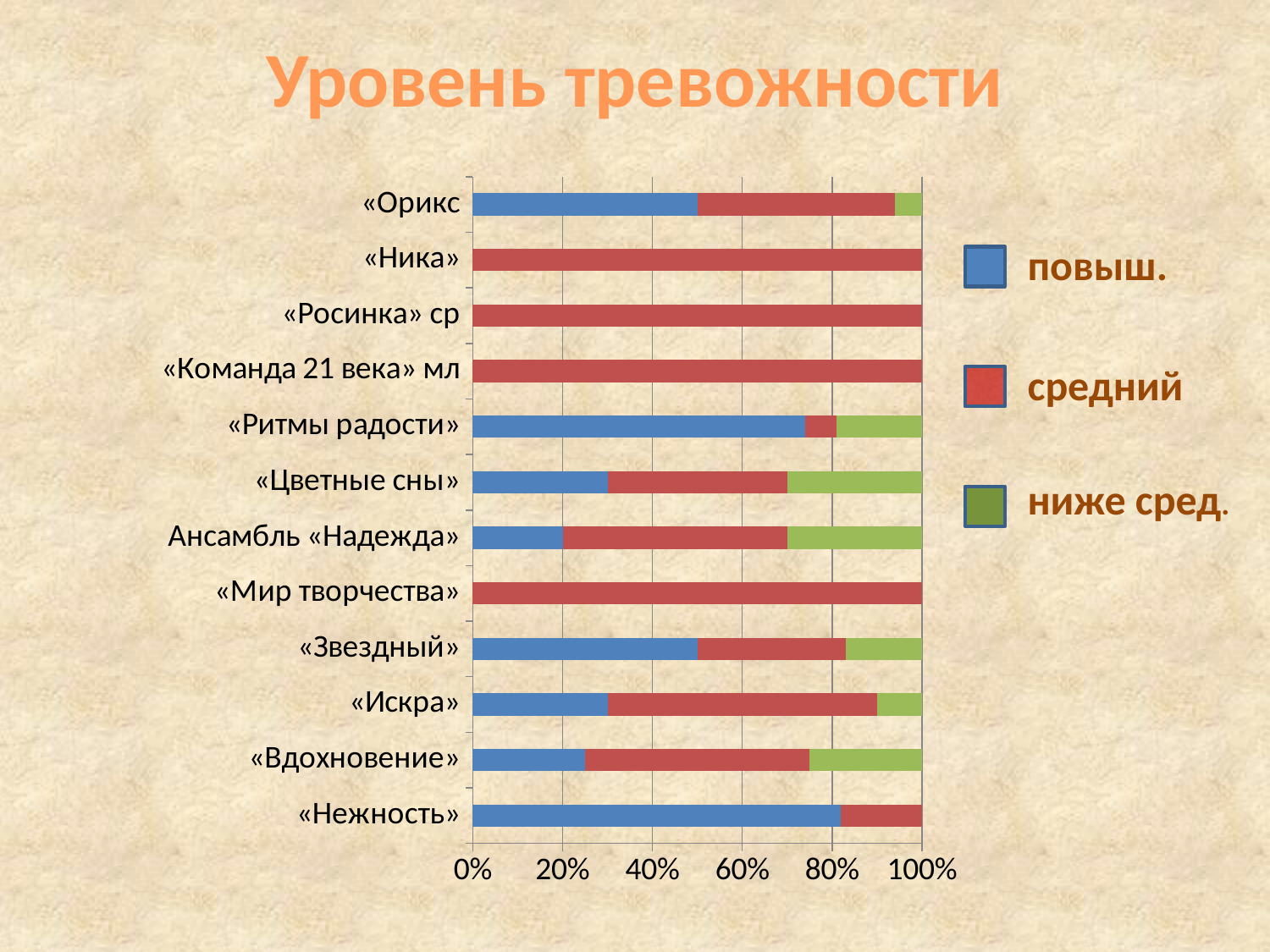
Is the "повыш." share for «Искра» greater or less than 40%? less What kind of chart is shown on the slide? stacked bar chart Is the "повыш." share for «Орикс» greater or less than 40%? greater Is the "повыш." share for «Вдохновение» greater or less than 20%? greater Which has the larger "ниже сред." share, «Цветные сны» or «Орикс»? «Цветные сны» What is the title of the chart? Уровень тревожности How many categories are plotted on the chart? 12 Which category has the largest share for the series "повыш."? «Нежность» Which has the larger "повыш." share, «Нежность» or «Орикс»? «Нежность» How many series does the legend list? 3 Which series is shown in green in the legend? ниже сред.